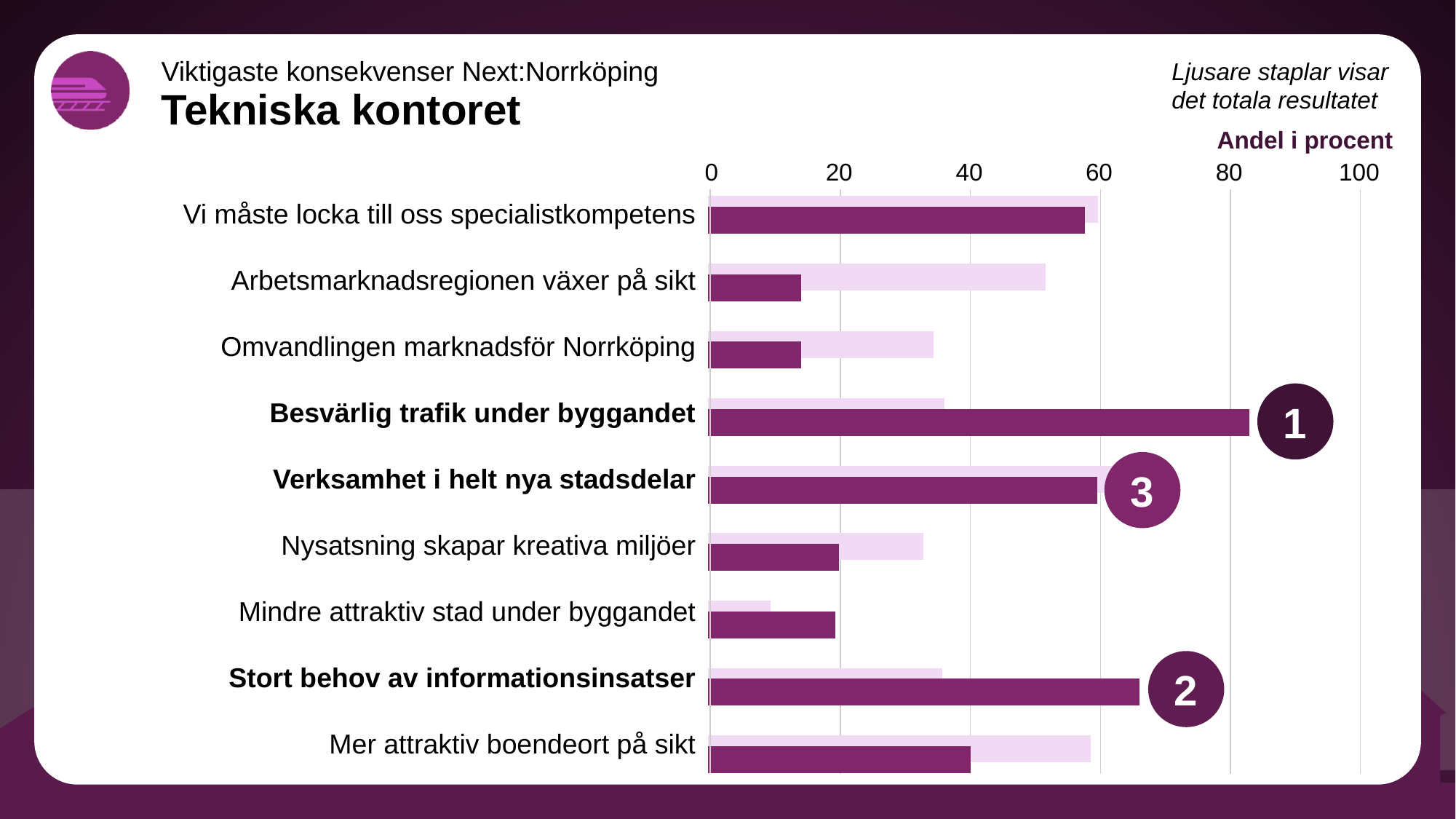
Which category is marked with the number 1 on the chart? Besvärlig trafik under byggandet Is the dark bar value for Arbetsmarknadsregionen växer på sikt greater or less than 20? less Which category has the shortest light bar? Mindre attraktiv stad under byggandet What is the axis label shown above the value axis? Andel i procent Is the dark bar value for Besvärlig trafik under byggandet greater or less than 80? greater Is the dark bar value for Stort behov av informationsinsatser greater or less than 60? greater For Besvärlig trafik under byggandet, which bar is longer, the dark bar or the light bar? the dark bar What kind of chart is shown on the slide? Bar chart How many categories are plotted on the chart? 9 Which category has the longest dark bar? Besvärlig trafik under byggandet For Arbetsmarknadsregionen växer på sikt, which bar is longer, the dark bar or the light bar? the light bar